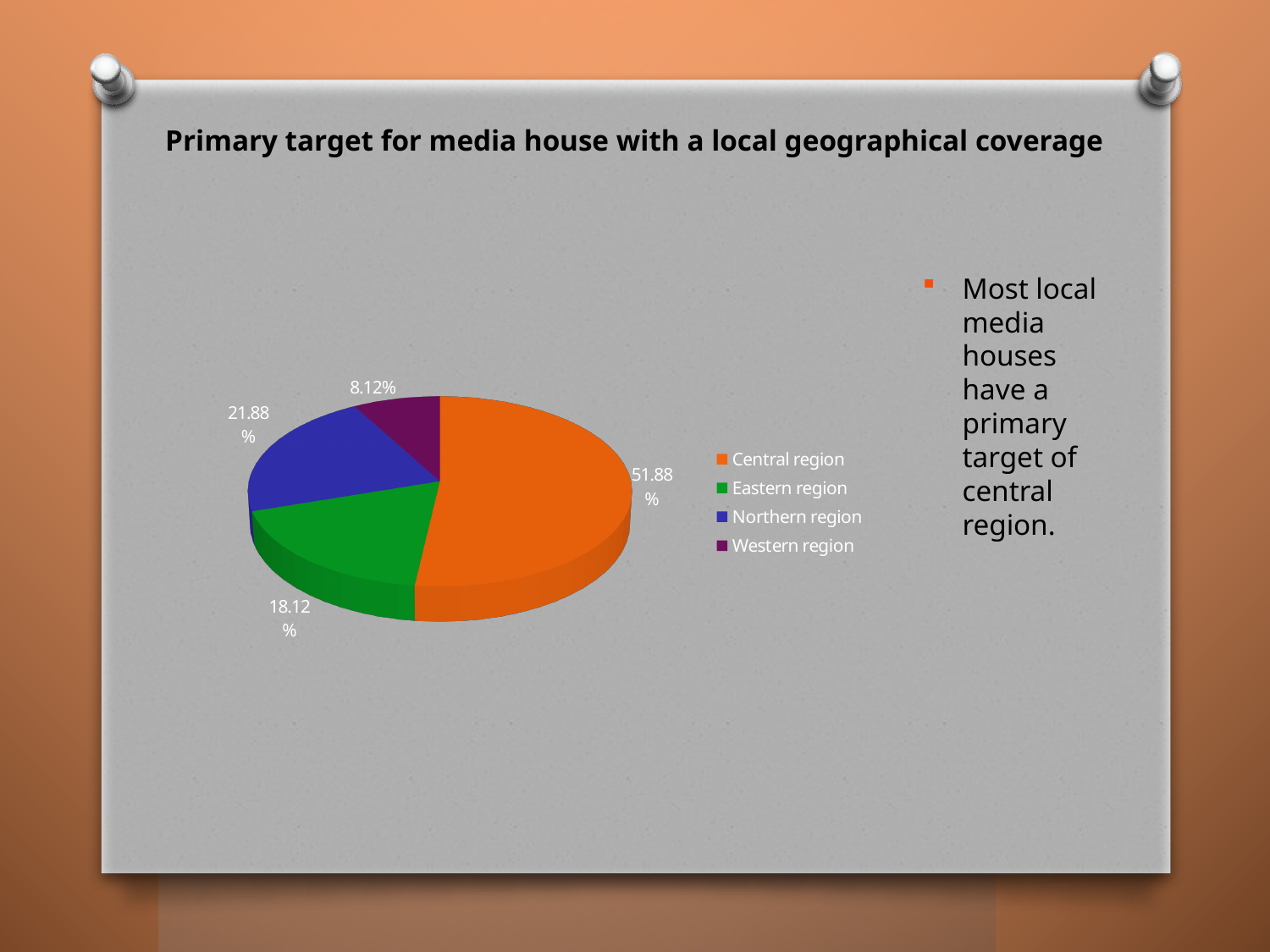
What colour is the Central region slice? orange What kind of chart is shown on the slide? pie chart What share of the pie does Eastern region have? 18.12% What share of the pie does Central region have? 51.88% Which region has the largest slice of the pie? Central region What share of the pie does Northern region have? 21.88% Which is larger, the Northern region share or the Eastern region share? Northern region Which region has the smallest slice of the pie? Western region What is the difference between the Central region and Northern region shares? 30% What is the combined share of Eastern region and Western region? 26.24% What share of the pie does Western region have? 8.12% How many slices does the pie chart have? 4